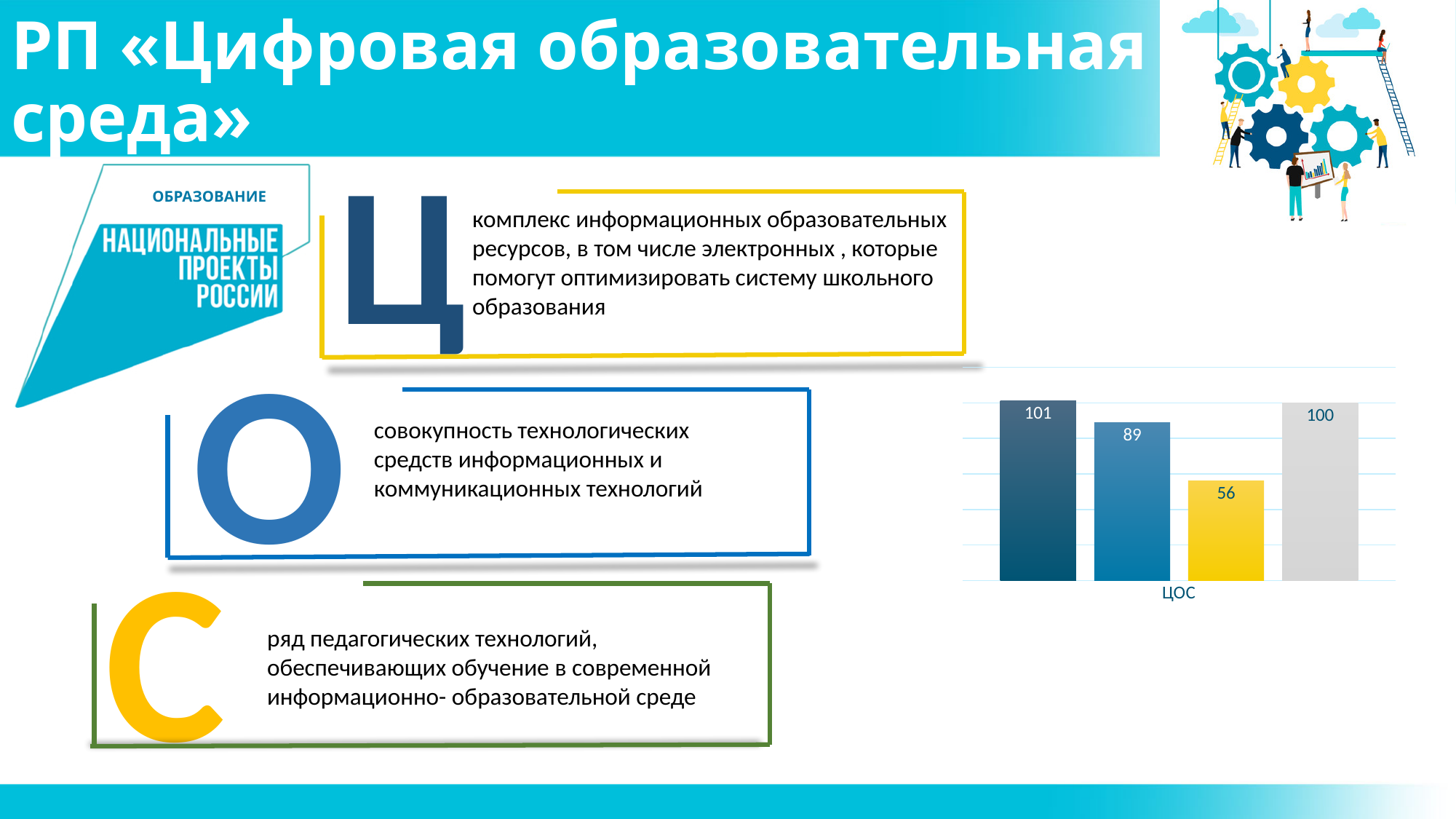
What is the difference between the first bar (101) and the yellow bar (56) in the chart? 45 How many bars does the chart on the right side of the slide show? 4 What is the value of the second (blue) bar in the chart? 89 What is the value of the first (leftmost, dark blue) bar in the chart? 101 What kind of chart is shown on the right side of the slide? bar chart Which bar in the chart has the highest value? the first (dark blue) bar, 101 Which is larger in the chart: the second (blue) bar or the grey bar? the grey bar What is the value of the grey (rightmost) bar in the chart? 100 What is the value of the yellow bar in the chart? 56 What label is shown on the horizontal axis of the chart? ЦОС Which bar in the chart has the lowest value? the yellow bar, 56 What is the difference between the grey bar (100) and the second bar (89) in the chart? 11